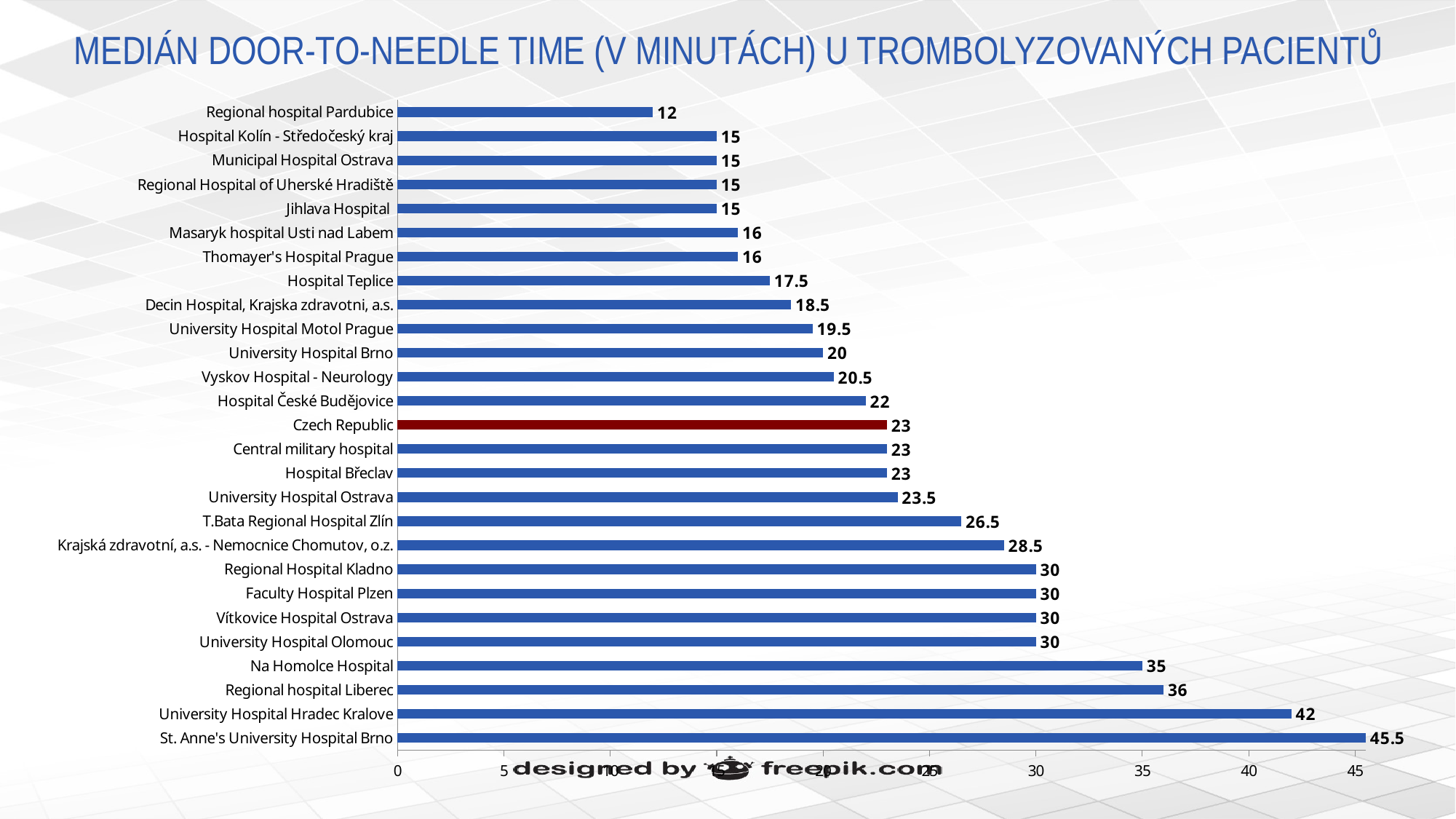
What is the difference between the values for University Hospital Hradec Kralove and Na Homolce Hospital? 7 Which hospital has the highest median door-to-needle time? St. Anne's University Hospital Brno What is the median door-to-needle time for University Hospital Motol Prague? 19.5 Which bar is coloured dark red instead of blue? Czech Republic Which hospital has the lowest median door-to-needle time? Regional hospital Pardubice What type of chart is shown on the slide? Bar chart What is the median door-to-needle time for Regional hospital Liberec? 36 What is the difference between the values for Krajská zdravotní, a.s. - Nemocnice Chomutov, o.z. and Hospital Teplice? 11 Is the value for Regional Hospital Kladno greater or less than 25? greater How many bars are shown in the chart? 27 Which has a larger value, T.Bata Regional Hospital Zlín or University Hospital Ostrava? T.Bata Regional Hospital Zlín What is the value shown for Czech Republic? 23